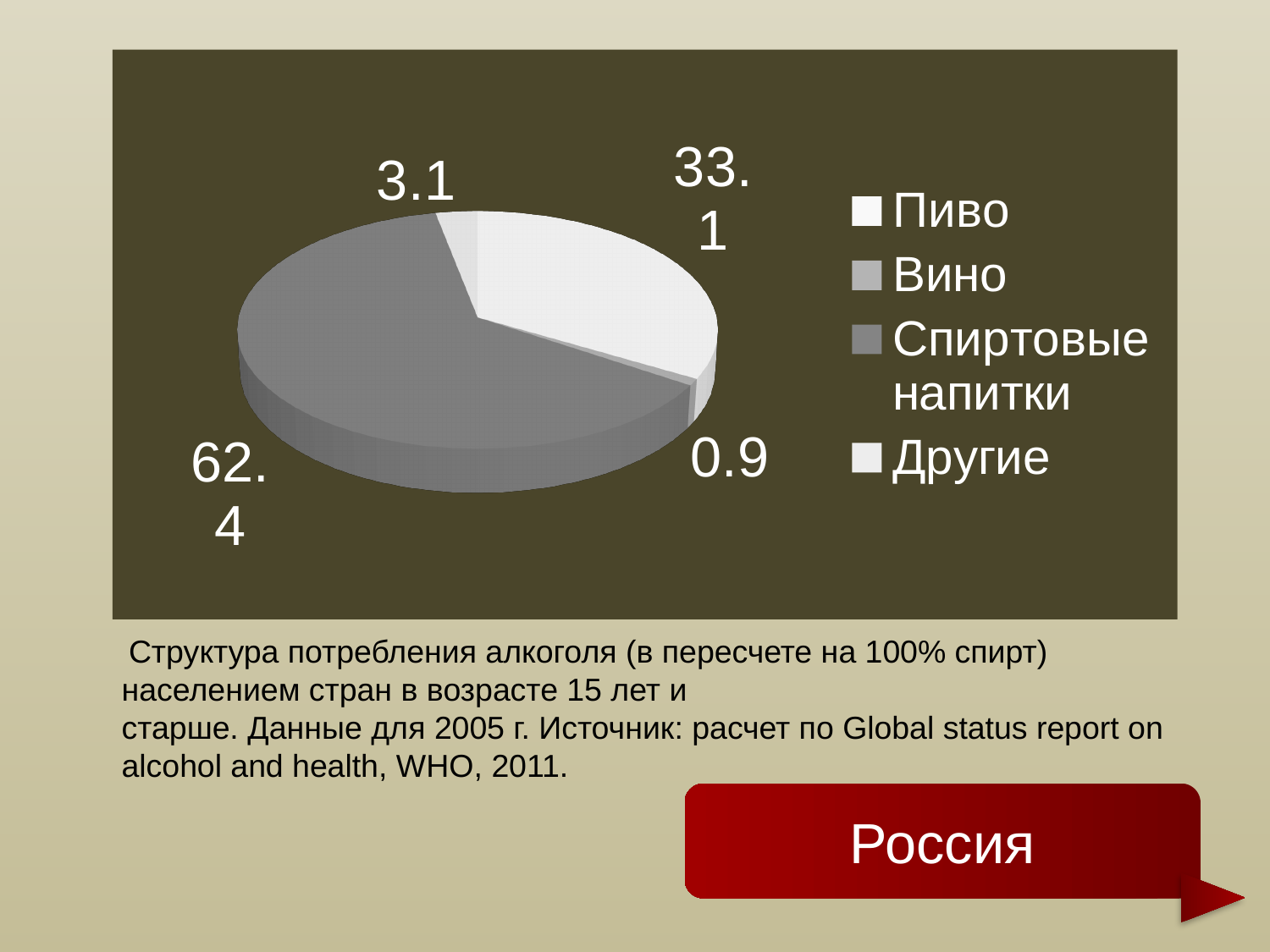
What is the value shown for Вино in the pie chart? 0.9 What is the value shown for Пиво in the pie chart? 33.1 Which is larger, the value for Другие or the value for Вино? Другие What is the value shown for Другие in the pie chart? 3.1 Which country is named in the red box below the chart? Россия How many categories does the pie chart have? 4 What type of chart is shown on the slide? Pie chart What is the difference between the values for Спиртовые напитки and Пиво? 29.3 What is the value shown for Спиртовые напитки in the pie chart? 62.4 How many entries does the legend list? 4 Which category has the largest slice of the pie? Спиртовые напитки Which category has the smallest slice of the pie? Вино